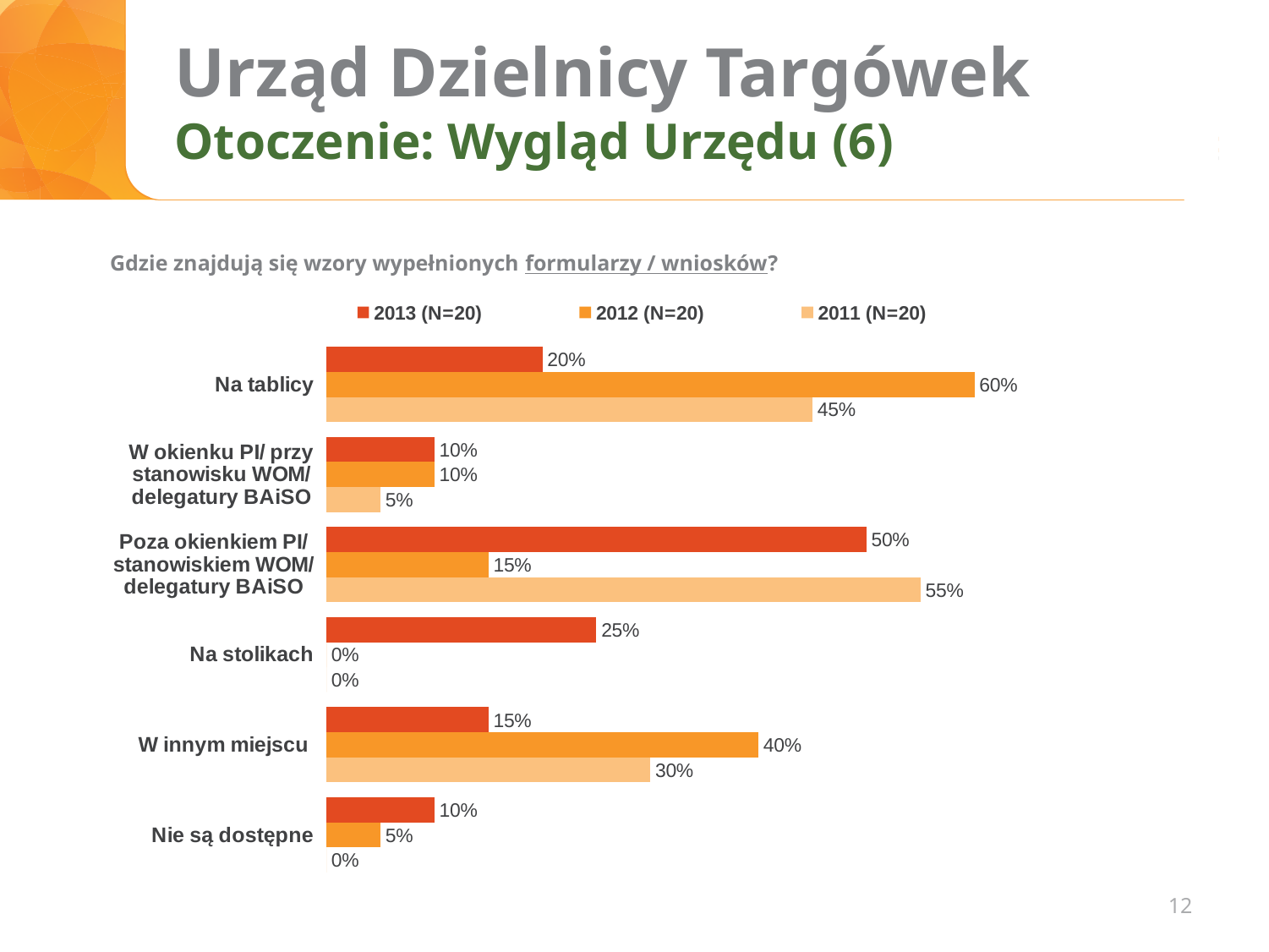
What is the value for "W innym miejscu" in the 2011 (N=20) series? 30% What is the value for "Na tablicy" in the 2012 (N=20) series? 60% What is the value for "Na stolikach" in the 2013 (N=20) series? 25% What kind of chart is shown on the slide? Bar chart Which is larger for "Poza okienkiem PI/ stanowiskiem WOM/ delegatury BAiSO": the 2011 (N=20) value or the 2012 (N=20) value? 2011 (N=20) What is the value for "Nie są dostępne" in the 2011 (N=20) series? 0% How many series does the legend list? 3 Which category has the lowest value in the 2012 (N=20) series? Na stolikach Which category has the highest value in the 2013 (N=20) series? Poza okienkiem PI/ stanowiskiem WOM/ delegatury BAiSO How many categories are shown on the chart? 6 What question does the chart answer, according to the text above it? Gdzie znajdują się wzory wypełnionych formularzy / wniosków? What is the difference between the 2012 (N=20) and 2013 (N=20) values for "Na tablicy"? 40%